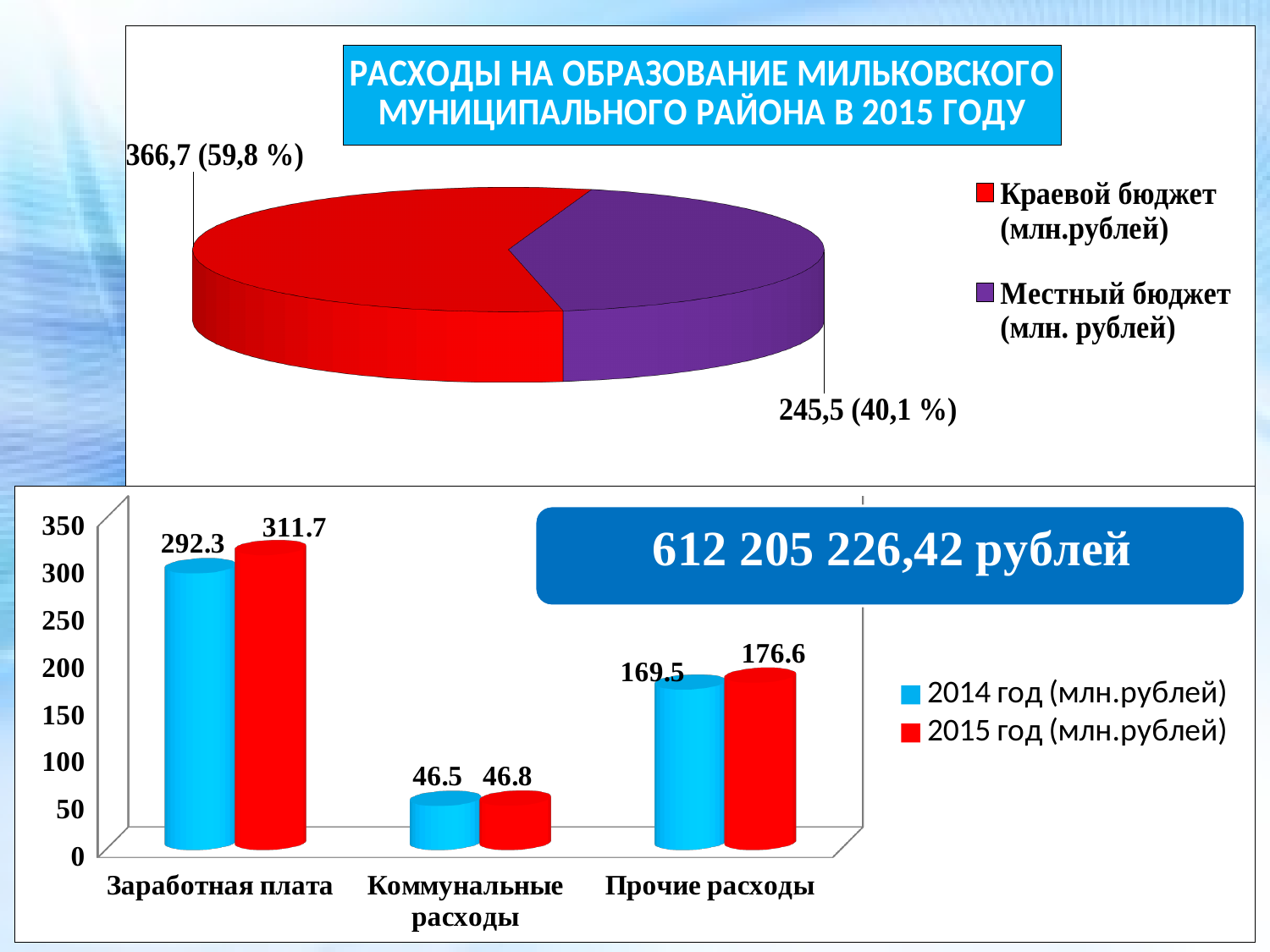
In the bar chart at the bottom of the slide, which category has the highest value for 2014 год? Заработная плата In the pie chart at the top of the slide, which slice is larger, Краевой бюджет or Местный бюджет? Краевой бюджет In the bar chart at the bottom of the slide, what is the value for Коммунальные расходы in 2014 год? 46.5 In the bar chart at the bottom of the slide, what is the value for Заработная плата in 2015 год? 311.7 How many categories are shown on the x axis of the bar chart at the bottom of the slide? 3 How many entries does the legend of the pie chart at the top of the slide list? 2 In the bar chart at the bottom of the slide, what is the difference between the 2015 год and 2014 год values for Прочие расходы? 7.1 What type of chart is the chart at the top of the slide? Pie chart In the pie chart at the top of the slide, what value is shown for Краевой бюджет? 366,7 (59,8 %) What type of chart is the chart at the bottom of the slide? Bar chart In the bar chart at the bottom of the slide, which category has the lowest value for 2015 год? Коммунальные расходы In the pie chart at the top of the slide, what share of the pie does Местный бюджет have? 40,1 %